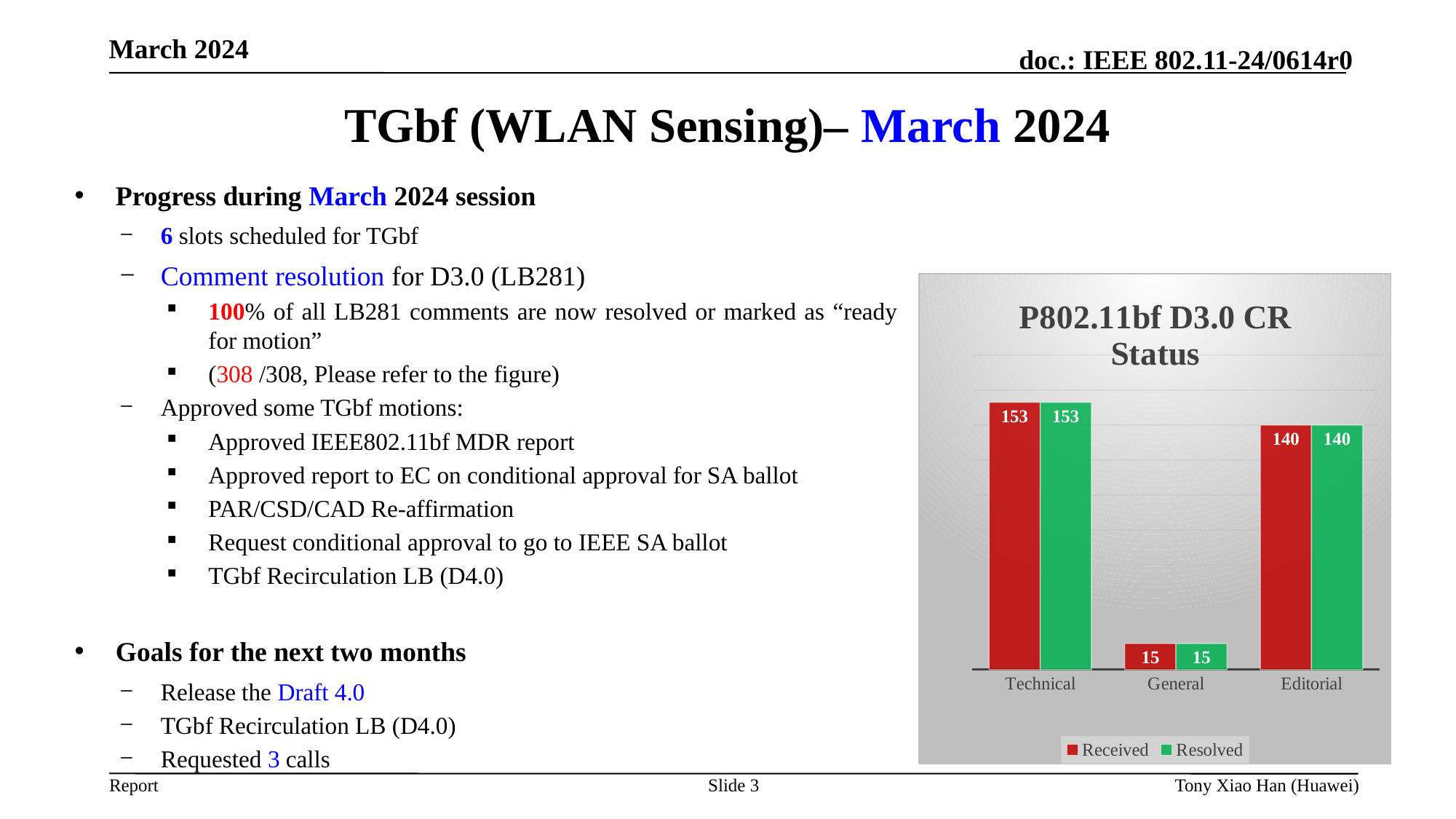
Which category has the lowest Resolved value in the P802.11bf D3.0 CR Status chart? General What is the Resolved value for General in the P802.11bf D3.0 CR Status chart? 15 What is the Received value for Technical in the P802.11bf D3.0 CR Status chart? 153 Which category has the highest Received value in the P802.11bf D3.0 CR Status chart? Technical What is the difference between the Resolved values for Editorial and General in the P802.11bf D3.0 CR Status chart? 125 What type of chart is the P802.11bf D3.0 CR Status chart? Bar chart How many series does the legend of the P802.11bf D3.0 CR Status chart list? 2 What is the Received value for Editorial in the P802.11bf D3.0 CR Status chart? 140 What is the difference between the Received values for Technical and Editorial in the P802.11bf D3.0 CR Status chart? 13 Is the Received value for Technical or for Editorial larger in the P802.11bf D3.0 CR Status chart? Technical What colour are the Resolved bars in the P802.11bf D3.0 CR Status chart? Green How many categories are shown on the x axis of the P802.11bf D3.0 CR Status chart? 3